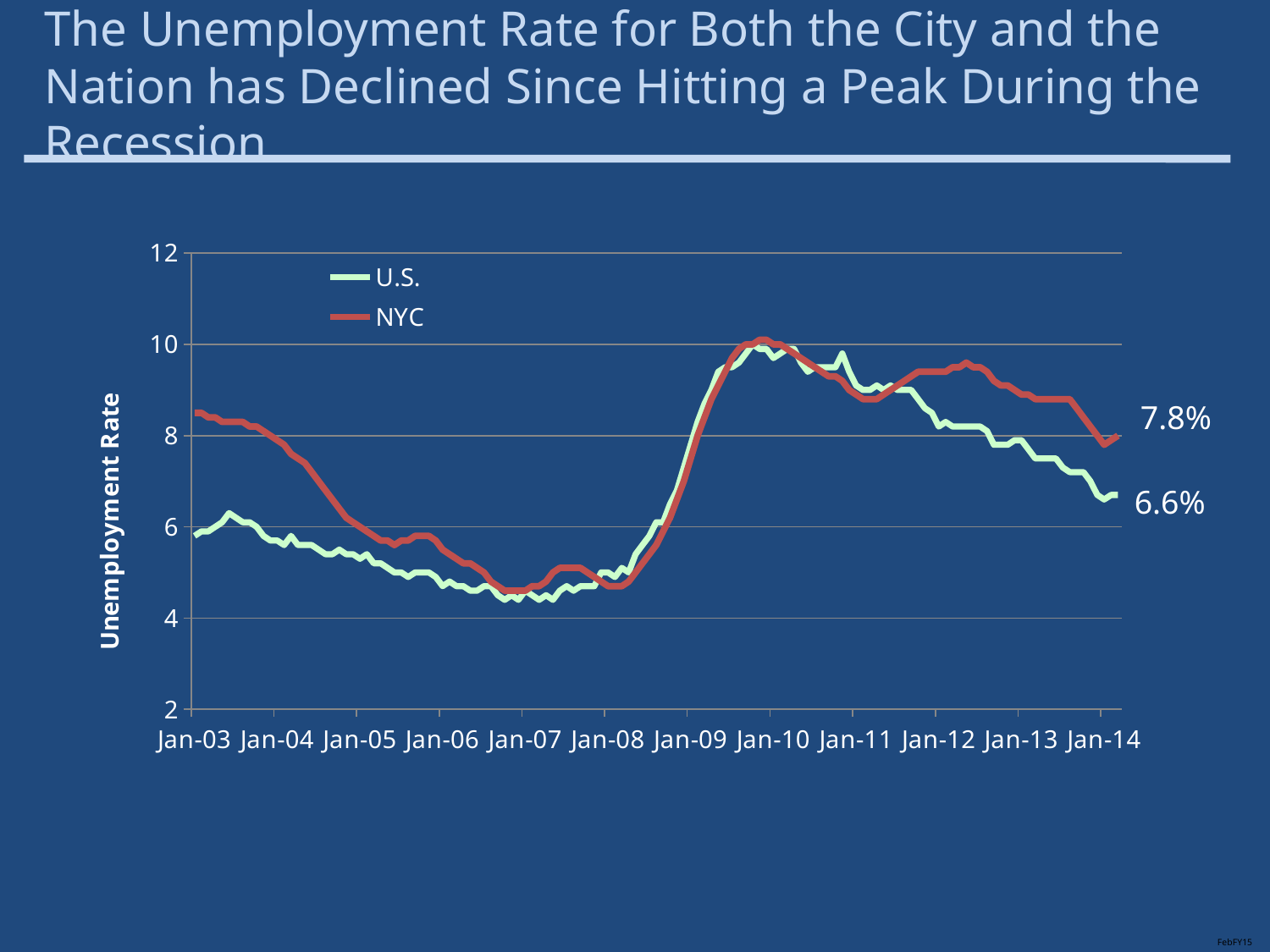
How many year labels are shown along the x axis? 12 What is the final labelled value for the U.S. series at the right end of the chart? 6.6% How many series does the legend list? 2 Is the NYC value at Jan-03 greater or less than 8? greater What is the title of the vertical axis? Unemployment Rate What is the final labelled value for the NYC series at the right end of the chart? 7.8% Is the NYC value at Jan-12 greater or less than 8? greater At the right end of the chart, which series has the higher unemployment rate, U.S. or NYC? NYC Does the U.S. unemployment rate rise or fall between Jan-10 and Jan-14? Fall What kind of chart is shown on the slide? Line chart What is the difference between the final labelled NYC value (7.8%) and the final labelled U.S. value (6.6%)? 1.2 percentage points Is the U.S. value at Jan-07 greater or less than 6? less